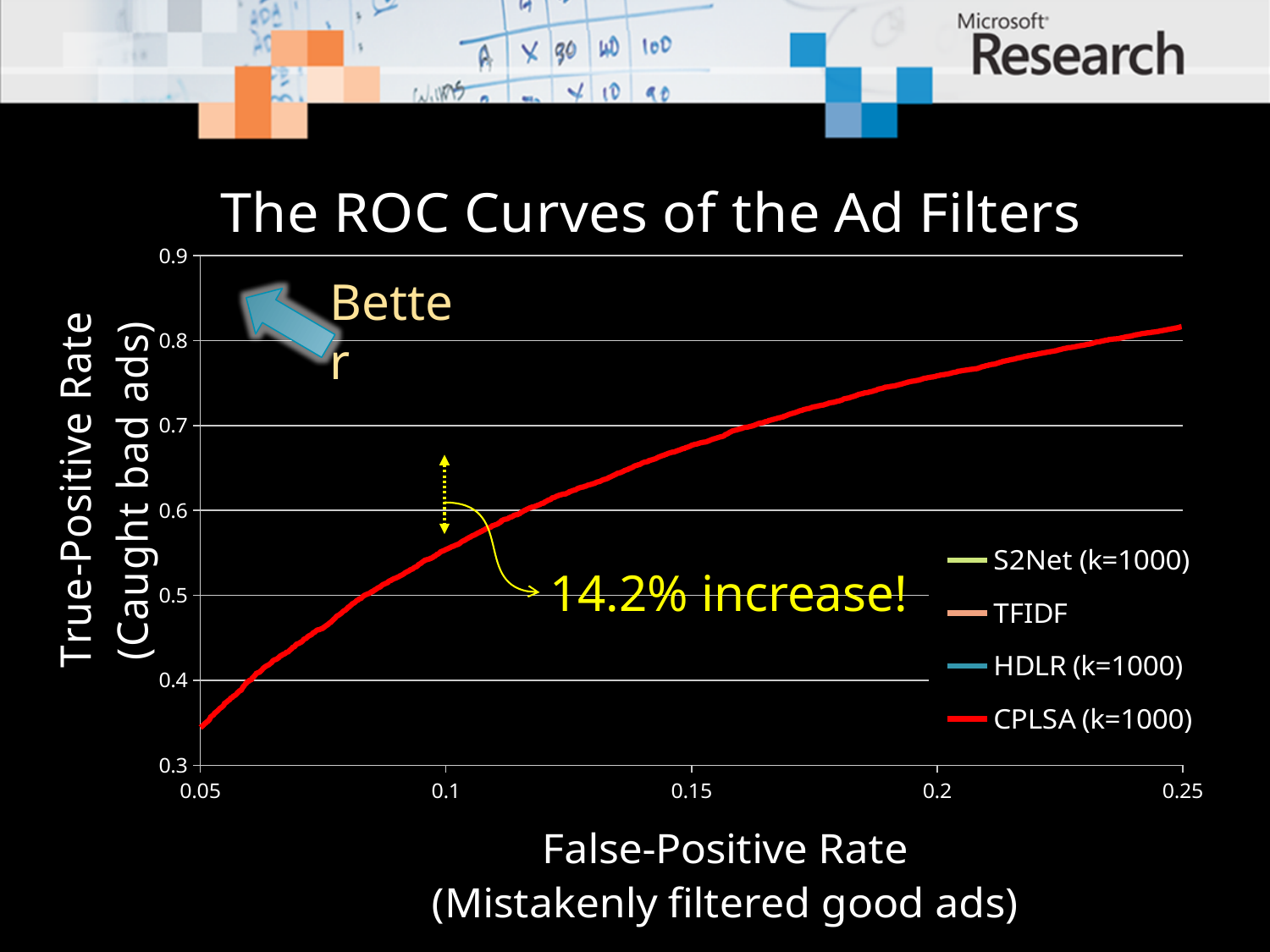
Which series is drawn in red in the legend? CPLSA (k=1000) What percentage increase is called out in the annotation on the chart? 14.2% What is the highest value shown on the y axis of the chart? 0.9 How many series does the legend list? 4 Is the true-positive rate of the CPLSA (k=1000) curve at a false-positive rate of 0.2 greater or less than 0.7? greater What kind of chart is shown on the slide? line chart Is the true-positive rate of the CPLSA (k=1000) curve at a false-positive rate of 0.25 greater or less than 0.8? greater Is the true-positive rate of the CPLSA (k=1000) curve at a false-positive rate of 0.1 greater or less than 0.6? less What is the lowest value shown on the x axis of the chart? 0.05 Does the CPLSA (k=1000) curve rise or fall as the false-positive rate increases along the x axis? rise What is the title of the chart? The ROC Curves of the Ad Filters